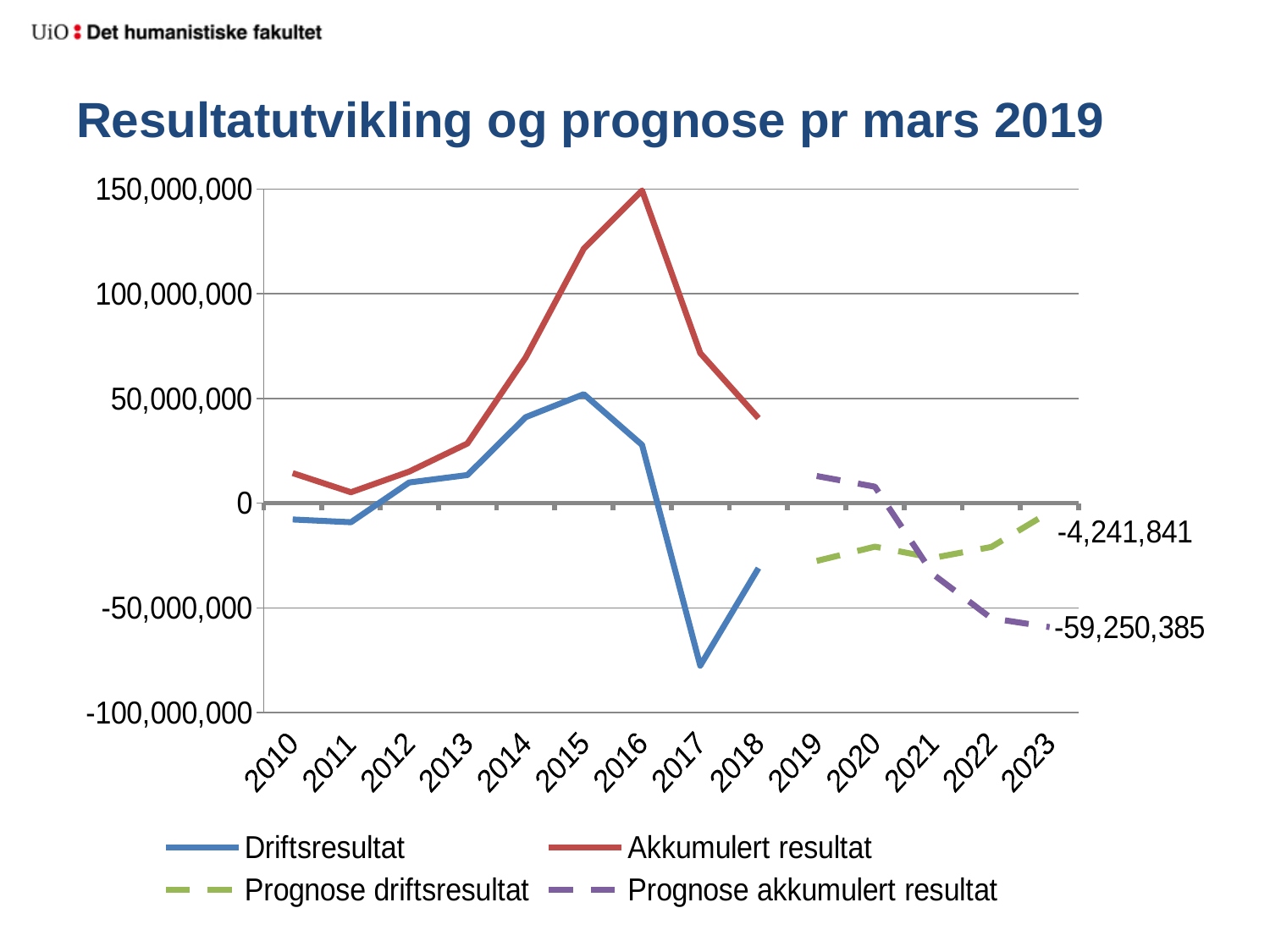
Does Prognose akkumulert resultat rise or fall from 2019 to 2023? fall What kind of chart is shown on the slide? line chart In which year does Akkumulert resultat reach its highest value? 2016 How many years are shown on the x axis? 14 What is the value of Prognose akkumulert resultat in 2023? -59,250,385 Which is larger, Akkumulert resultat in 2016 or in 2018? 2016 Is the value for Driftsresultat in 2017 greater or less than -50,000,000? less How many series does the legend list? 4 In which year is Driftsresultat at its lowest? 2017 Is the value for Driftsresultat in 2014 greater or less than 50,000,000? less Is the value for Akkumulert resultat in 2016 greater or less than 100,000,000? greater What is the value of Prognose driftsresultat in 2023? -4,241,841